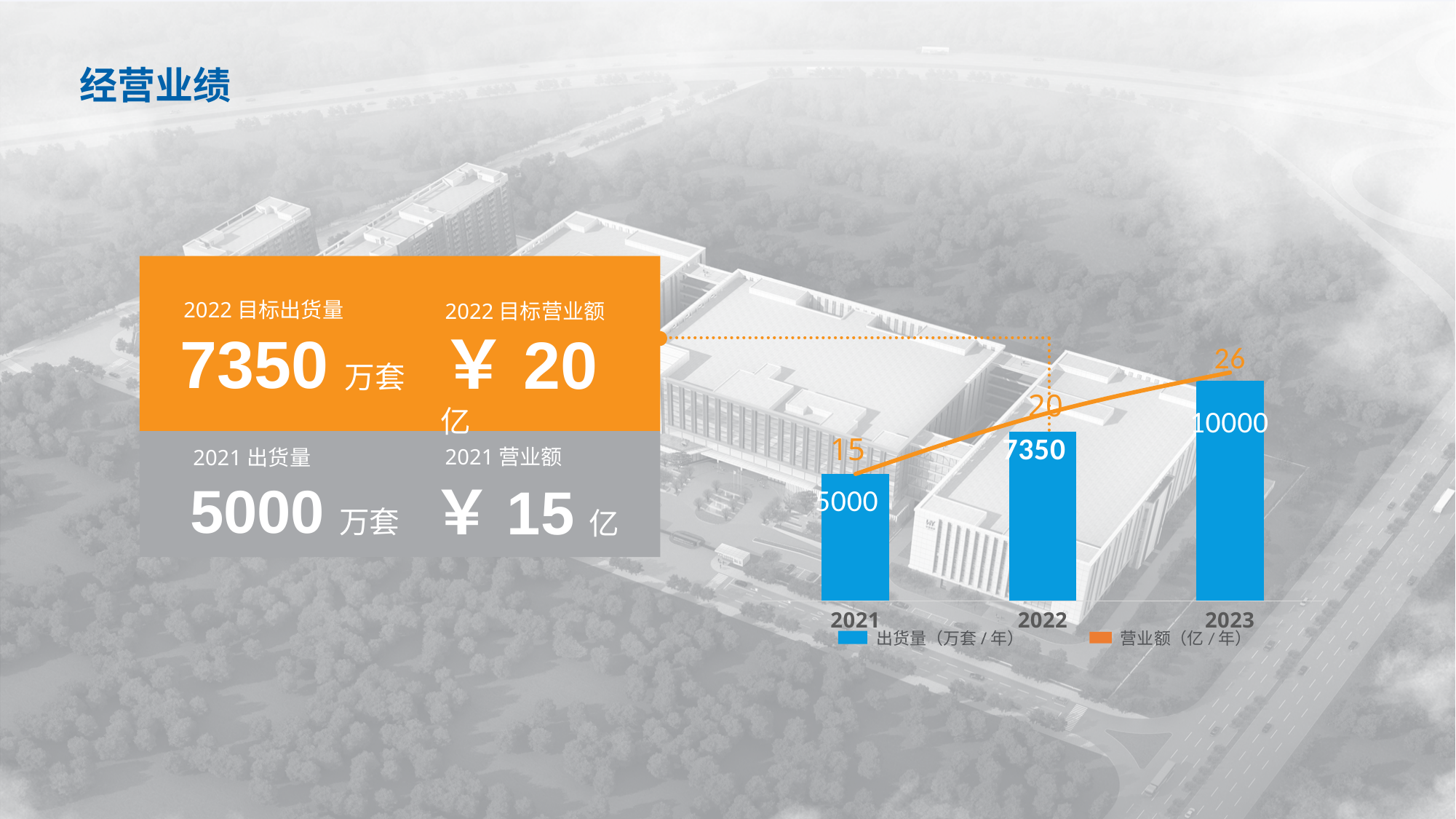
Which year has the highest 出货量? 2023 What is the 出货量 value for 2021? 5000 What is the 营业额 value for 2022? 20 How many years are shown on the x axis of the chart? 3 What is the 营业额 value for 2023? 26 What is the difference in 出货量 between 2023 and 2021? 5000 What is the 出货量 value for 2023? 10000 Does the 营业额 line rise or fall from 2021 to 2023? rise What is the difference in 营业额 between 2023 and 2022? 6 Which year has the lowest 营业额? 2021 Which year has a larger 出货量, 2021 or 2022? 2022 How many series does the chart legend list? 2